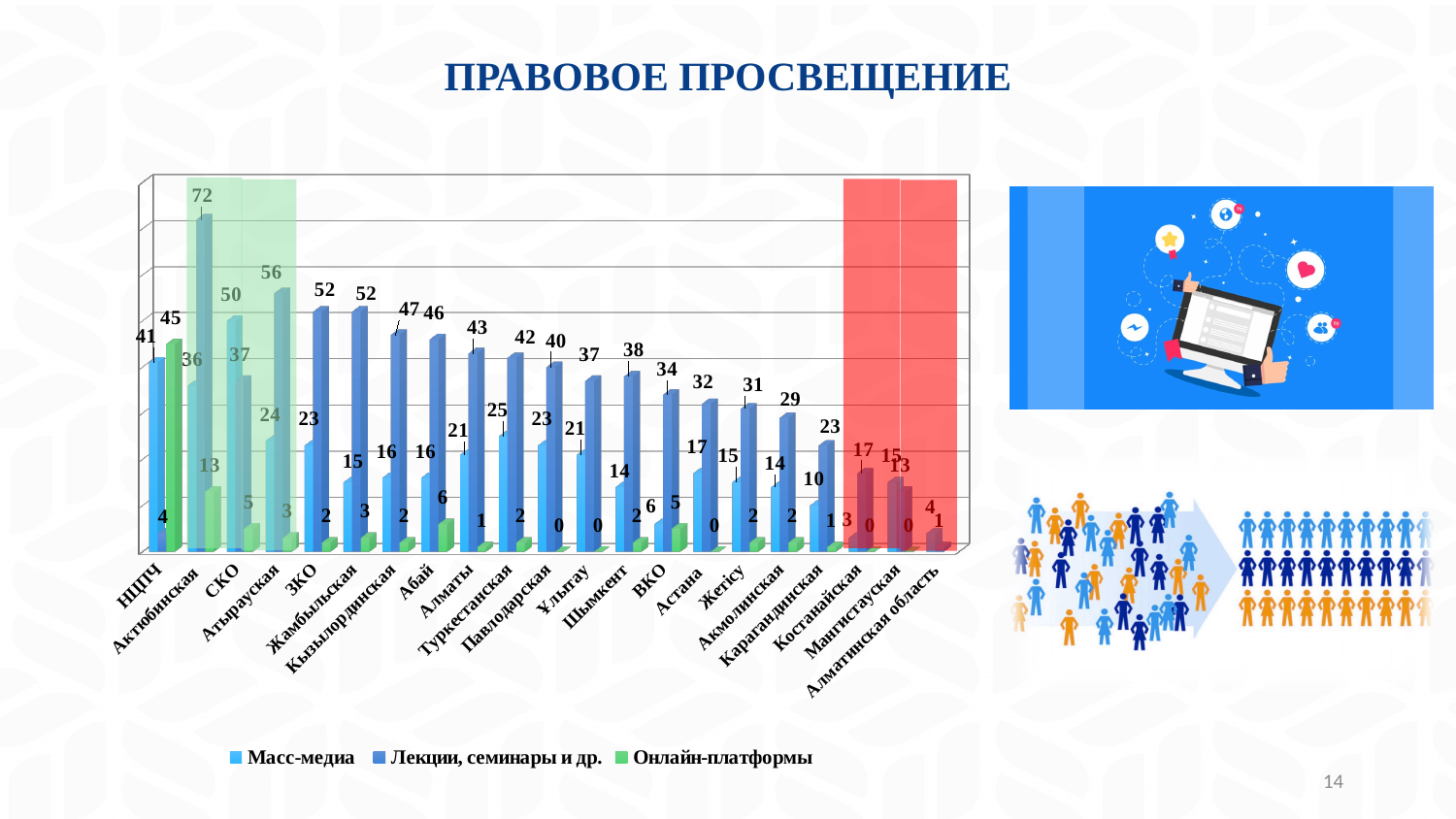
What is the value of Масс-медиа for СКО? 50 Which category has the highest value for Лекции, семинары и др.? Актюбинская What is the total of the three series for НЦПЧ? 90 What is the value of Лекции, семинары и др. for Актюбинская? 72 Which category has the highest value for Масс-медиа? СКО How many series does the legend list? 3 What is the difference between Лекции, семинары и др. and Масс-медиа for Актюбинская? 36 What kind of chart is shown on the slide? bar chart How many regions/categories are shown on the x axis? 21 What is the value of Онлайн-платформы for Актюбинская? 13 What are the three series named in the legend? Масс-медиа, Лекции, семинары и др., Онлайн-платформы Which has the larger Масс-медиа value, НЦПЧ or Актюбинская? НЦПЧ